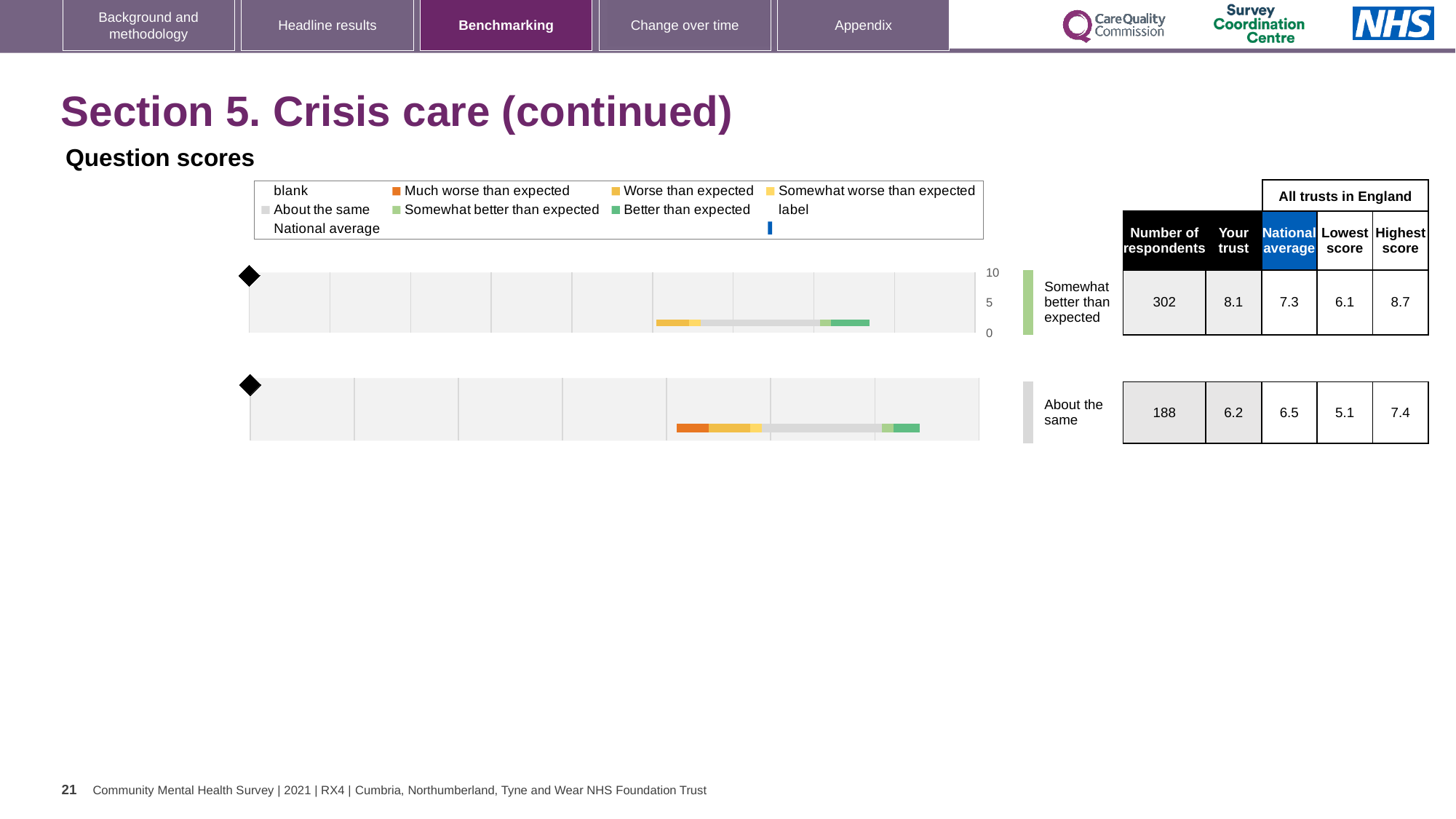
What benchmark category label is shown next to the top chart? Somewhat better than expected For the top chart, how many respondents are listed in the table? 302 For the top chart, what is the highest score among all trusts in England? 8.7 What kind of chart is used to show the question scores on this slide? bar chart For the top chart, what is the difference between the 'Your trust' score and the national average? 0.8 How many question score charts are shown on the slide? 2 What benchmark category label is shown next to the bottom chart? About the same For the bottom chart, how many respondents are listed in the table? 188 For the top chart, what is the national average score? 7.3 For the top chart, what is the 'Your trust' score? 8.1 For the bottom chart, what is the lowest score among all trusts in England? 5.1 For the bottom chart, which is larger: the 'Your trust' score or the national average? National average